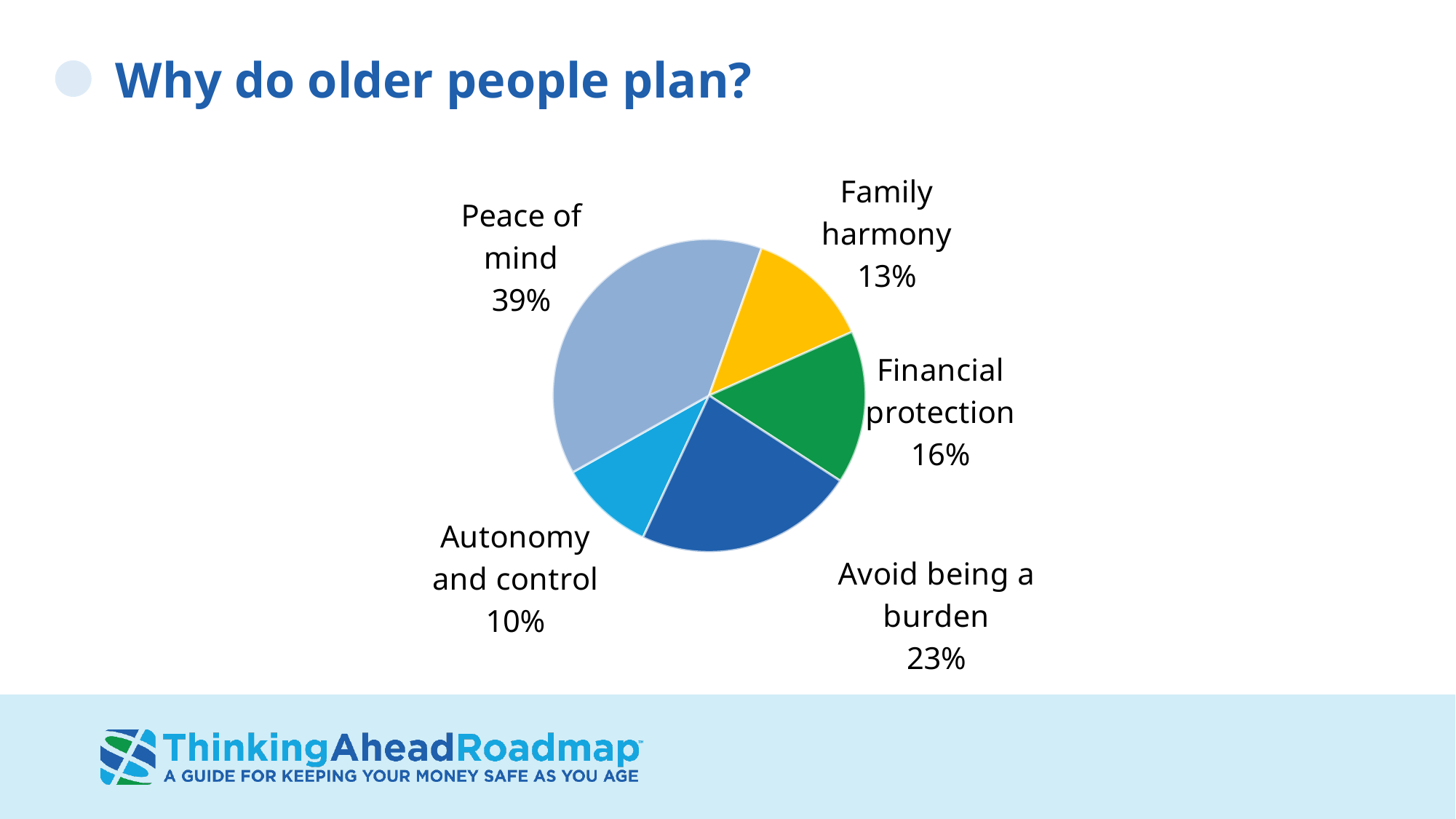
Which is larger, "Financial protection" or "Family harmony"? Financial protection What percentage is shown for "Avoid being a burden"? 23% Which slice of the pie is the largest? Peace of mind What kind of chart is shown on the slide? pie chart What is the title of the slide containing the pie chart? Why do older people plan? What percentage is shown for "Family harmony"? 13% Which slice of the pie is the smallest? Autonomy and control What is the difference in percentage points between "Peace of mind" and "Avoid being a burden"? 16 How many slices does the pie chart have? 5 What percentage is shown for "Financial protection"? 16% What share of the pie is labelled "Peace of mind"? 39% What percentage is shown for "Autonomy and control"? 10%